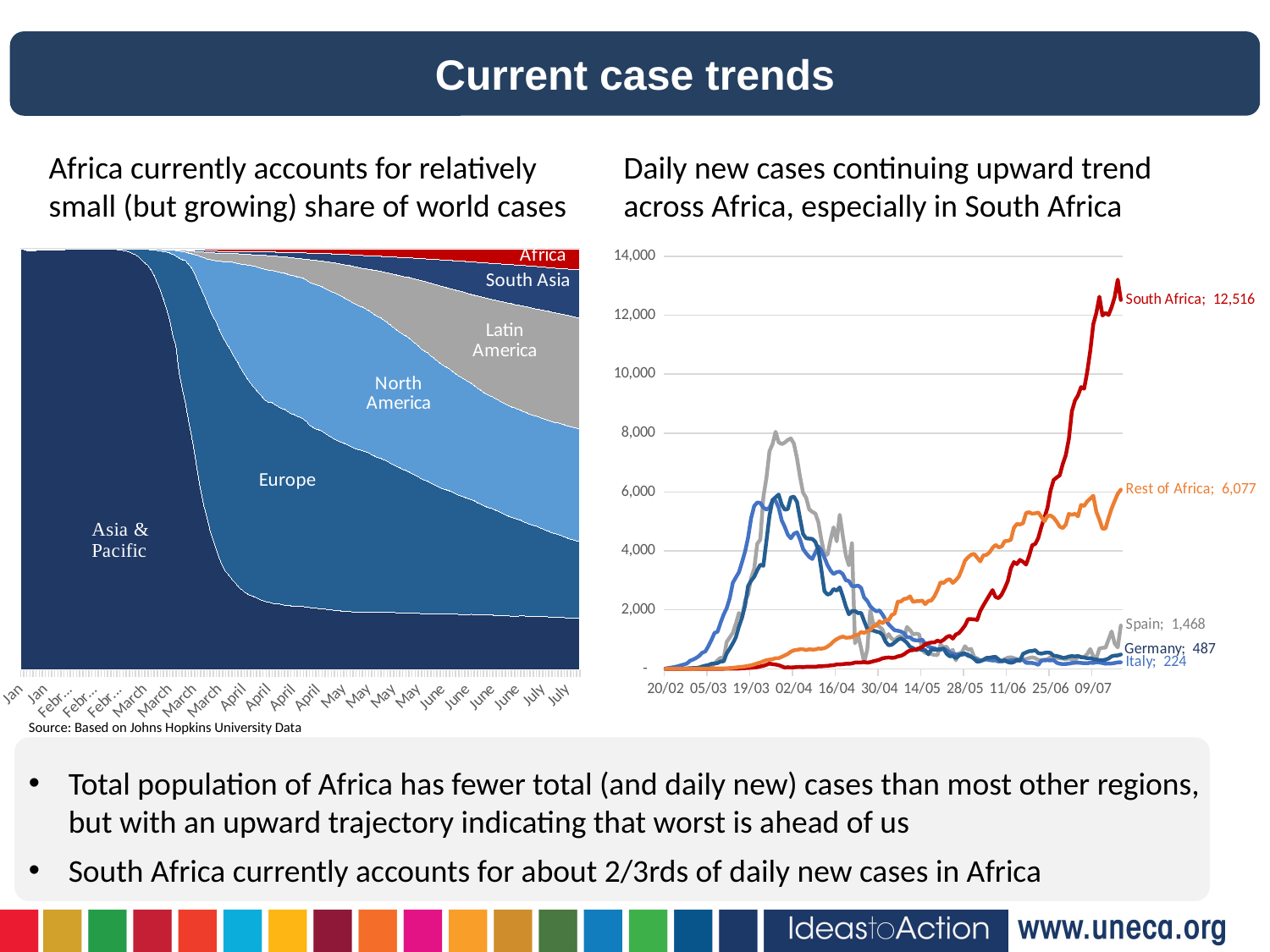
In the right-hand chart (daily new cases), what is the latest value shown for Spain? 1,468 In the right-hand chart (daily new cases), which labelled series has the lowest latest value? Italy In the right-hand chart (daily new cases), how many labelled series are plotted? 5 In the right-hand chart (daily new cases), what is the latest value shown for South Africa? 12,516 In the right-hand chart (daily new cases), which labelled series has the highest latest value? South Africa In the right-hand chart (daily new cases), which has the larger latest value, Rest of Africa or Spain? Rest of Africa In the right-hand chart (daily new cases), what is the latest value shown for Italy? 224 In the left-hand chart (share of world cases), how many regions are shown? 6 In the right-hand chart (daily new cases), is the peak of the grey (Spain) line greater or less than 6,000? greater In the right-hand chart (daily new cases), what is the difference between the latest values for South Africa and Rest of Africa? 6,439 In the right-hand chart (daily new cases), what is the latest value shown for Rest of Africa? 6,077 In the right-hand chart (daily new cases), what is the difference between the latest values for Germany and Italy? 263